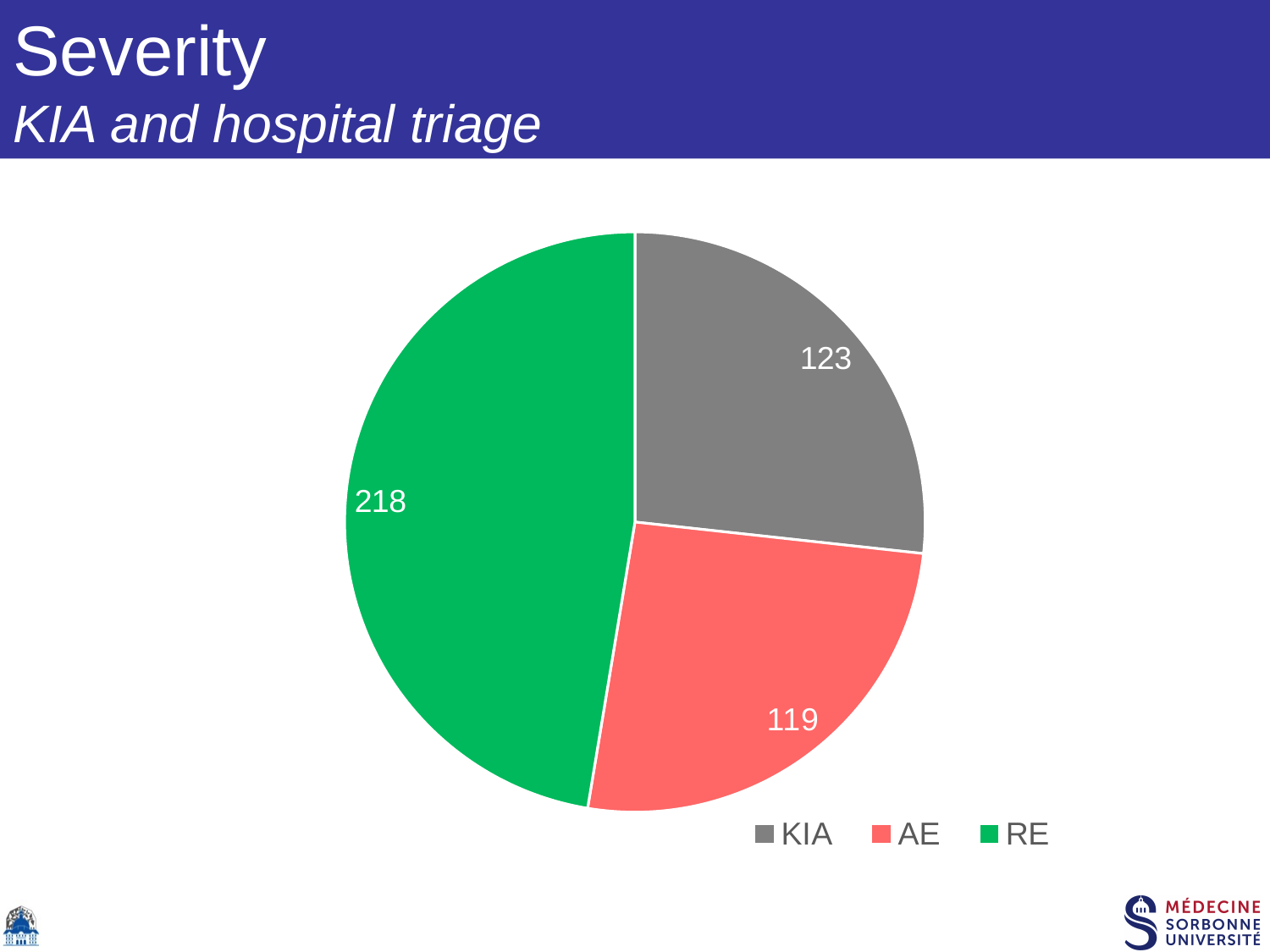
What is the value for RE? 218 Which category has the largest slice of the pie? RE Which is larger, the value for KIA or the value for AE? KIA What is the value for KIA? 123 What is the difference between the values for KIA and AE? 4 How many categories does the pie chart show? 3 What share of the total does RE represent? 47.4% Which category has the smallest slice of the pie? AE What is the difference between the values for RE and KIA? 95 What is the title of the slide containing the chart? Severity KIA and hospital triage What type of chart is shown on the slide? pie chart What is the value for AE? 119